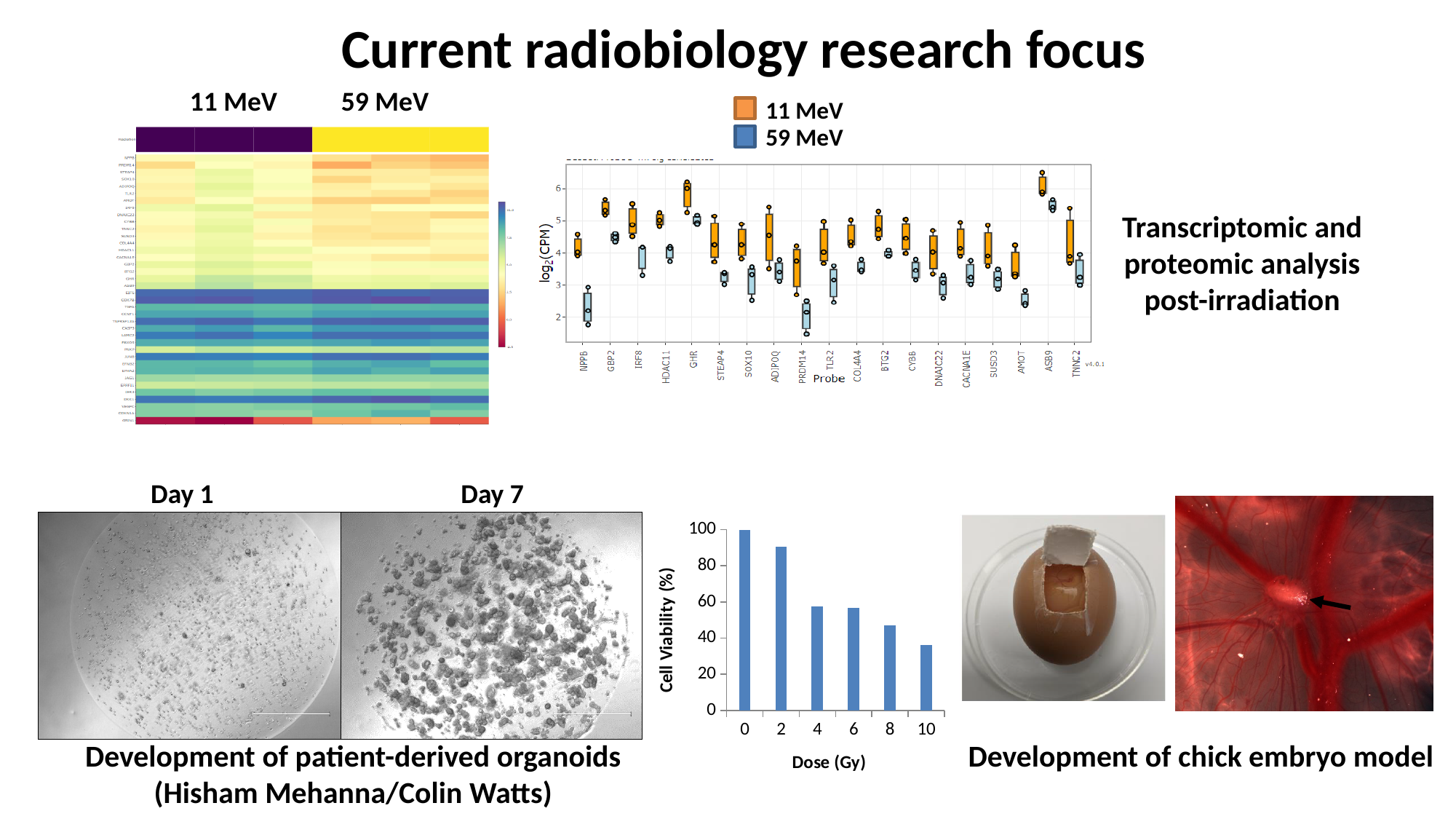
In the box plot of log2(CPM) by probe, which colour represents 59 MeV? blue In the cell viability bar chart, what kind of chart is it? bar chart In the box plot of log2(CPM) by probe, how many series does the legend list? 2 In the cell viability bar chart, does cell viability rise or fall as dose increases along the x axis? fall In the cell viability bar chart, what is the cell viability at a dose of 0 Gy? 100 In the cell viability bar chart, which has higher cell viability, 2 Gy or 8 Gy? 2 Gy In the cell viability bar chart, is the cell viability at 2 Gy greater or less than 80? greater In the cell viability bar chart, is the cell viability at 8 Gy greater or less than 60? less In the cell viability bar chart, which dose has the lowest cell viability? 10 In the cell viability bar chart, is the cell viability at 10 Gy greater or less than 40? less In the cell viability bar chart, how many dose categories are shown on the x axis? 6 In the cell viability bar chart, which dose has the highest cell viability? 0